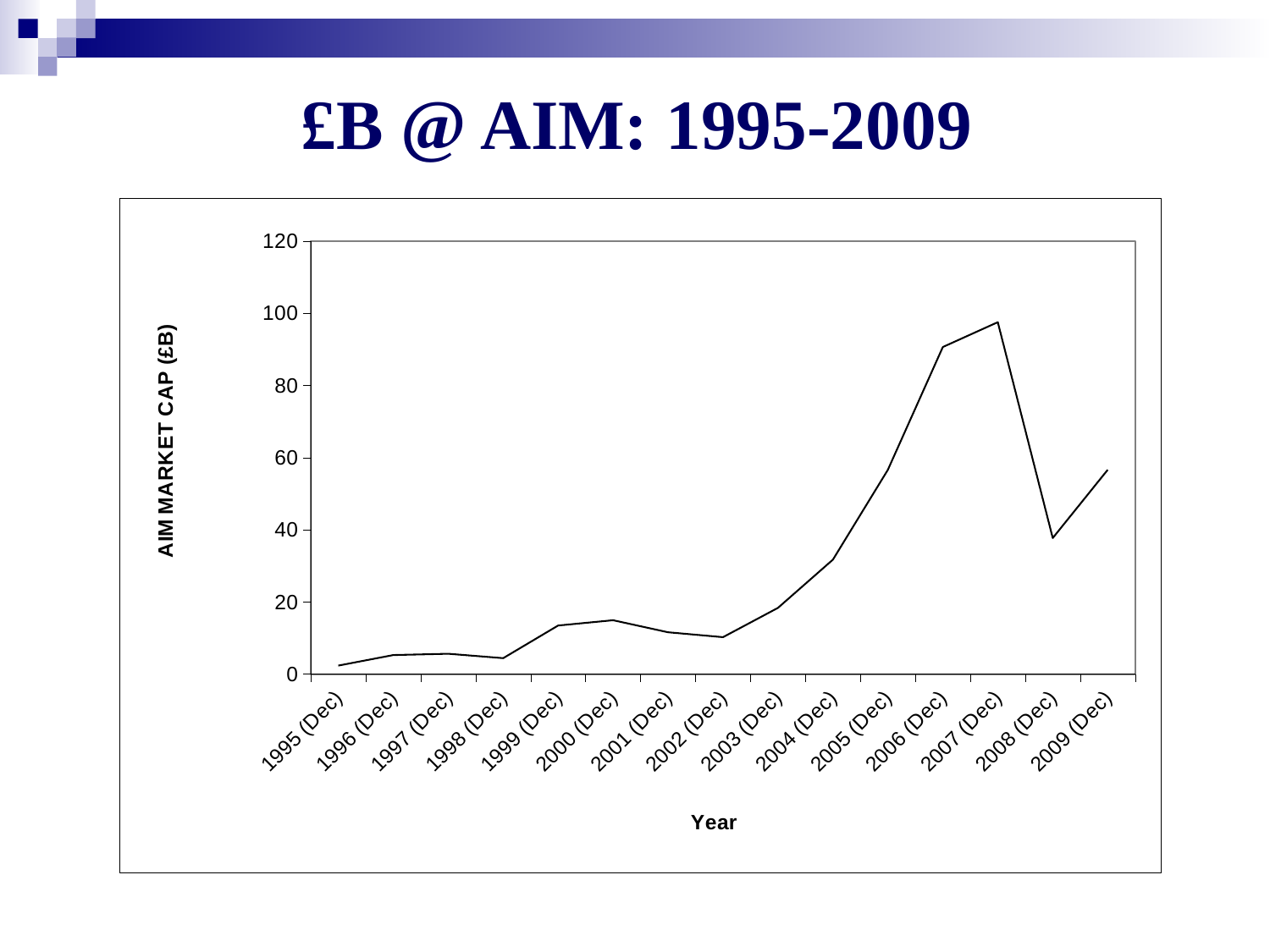
What is the label of the y axis? AIM MARKET CAP (£B) Which is larger, the AIM market cap in 2006 (Dec) or in 2008 (Dec)? 2006 (Dec) Is the AIM market cap for 2004 (Dec) greater or less than 20? greater What is the title of the slide? £B @ AIM: 1995-2009 Does the AIM market cap rise or fall between 2007 (Dec) and 2008 (Dec)? fall Which year has the highest AIM market cap? 2007 (Dec) What kind of chart is shown on the slide? line chart How many data points (years) are plotted on the x axis? 15 Is the AIM market cap for 2008 (Dec) greater or less than 60? less Is the AIM market cap for 2007 (Dec) greater or less than 80? greater Which year has the lowest AIM market cap? 1995 (Dec)